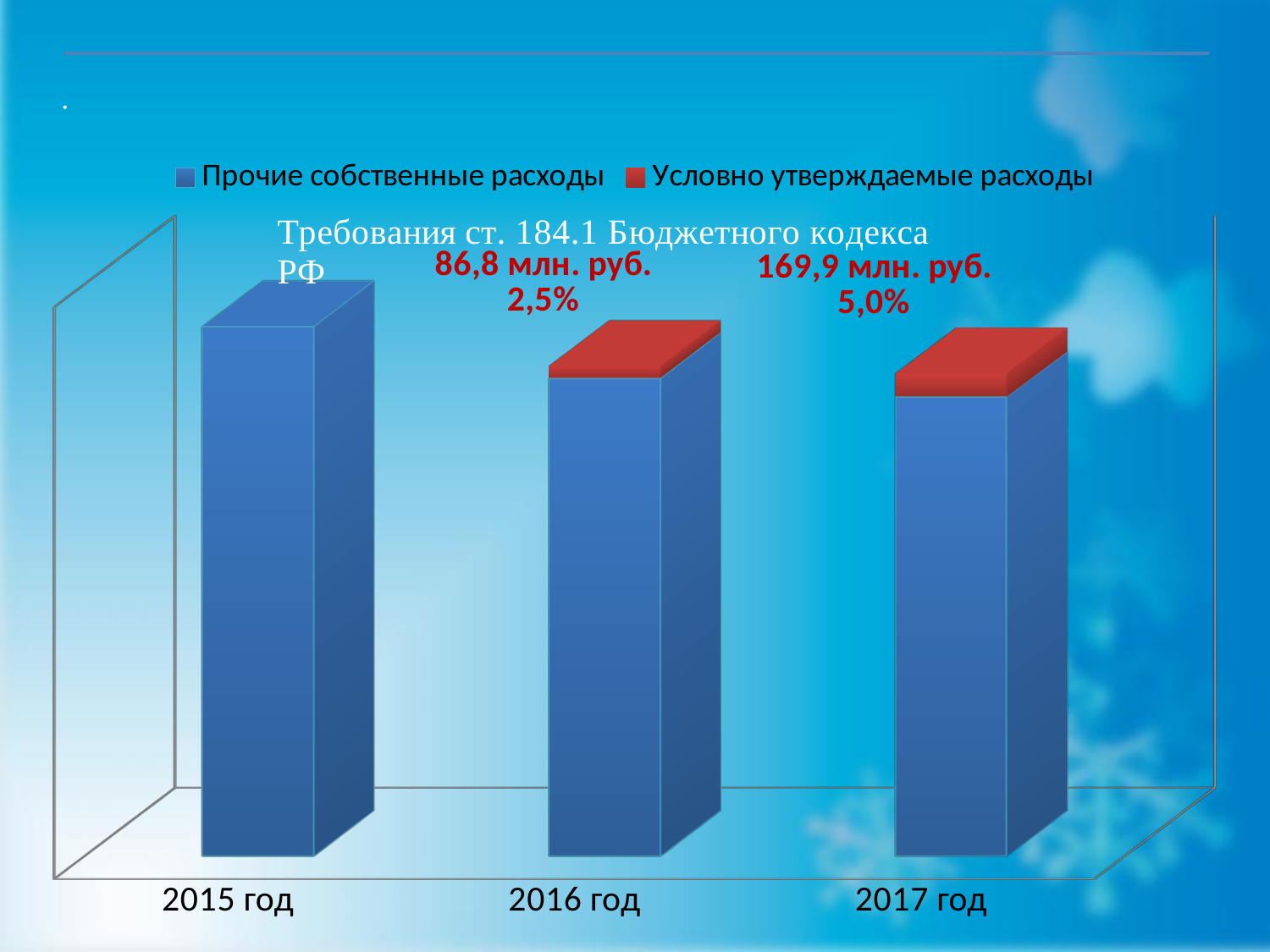
Does the value of Условно утверждаемые расходы rise or fall from 2016 год to 2017 год? Rises How many years are shown on the x axis? 3 What percentage is shown for Условно утверждаемые расходы in 2016 год? 2,5% Which year has the larger value of Условно утверждаемые расходы, 2016 год or 2017 год? 2017 год What percentage is shown for Условно утверждаемые расходы in 2017 год? 5,0% What is the value of Условно утверждаемые расходы for 2016 год? 86,8 млн. руб. Which colour represents Прочие собственные расходы in the legend? Blue By how much does the value of Условно утверждаемые расходы in 2017 год exceed that in 2016 год? 83,1 млн. руб. How many series does the legend list? 2 What is the value of Условно утверждаемые расходы for 2017 год? 169,9 млн. руб. Which year has no Условно утверждаемые расходы segment in its bar? 2015 год What kind of chart is shown on the slide? Stacked bar chart